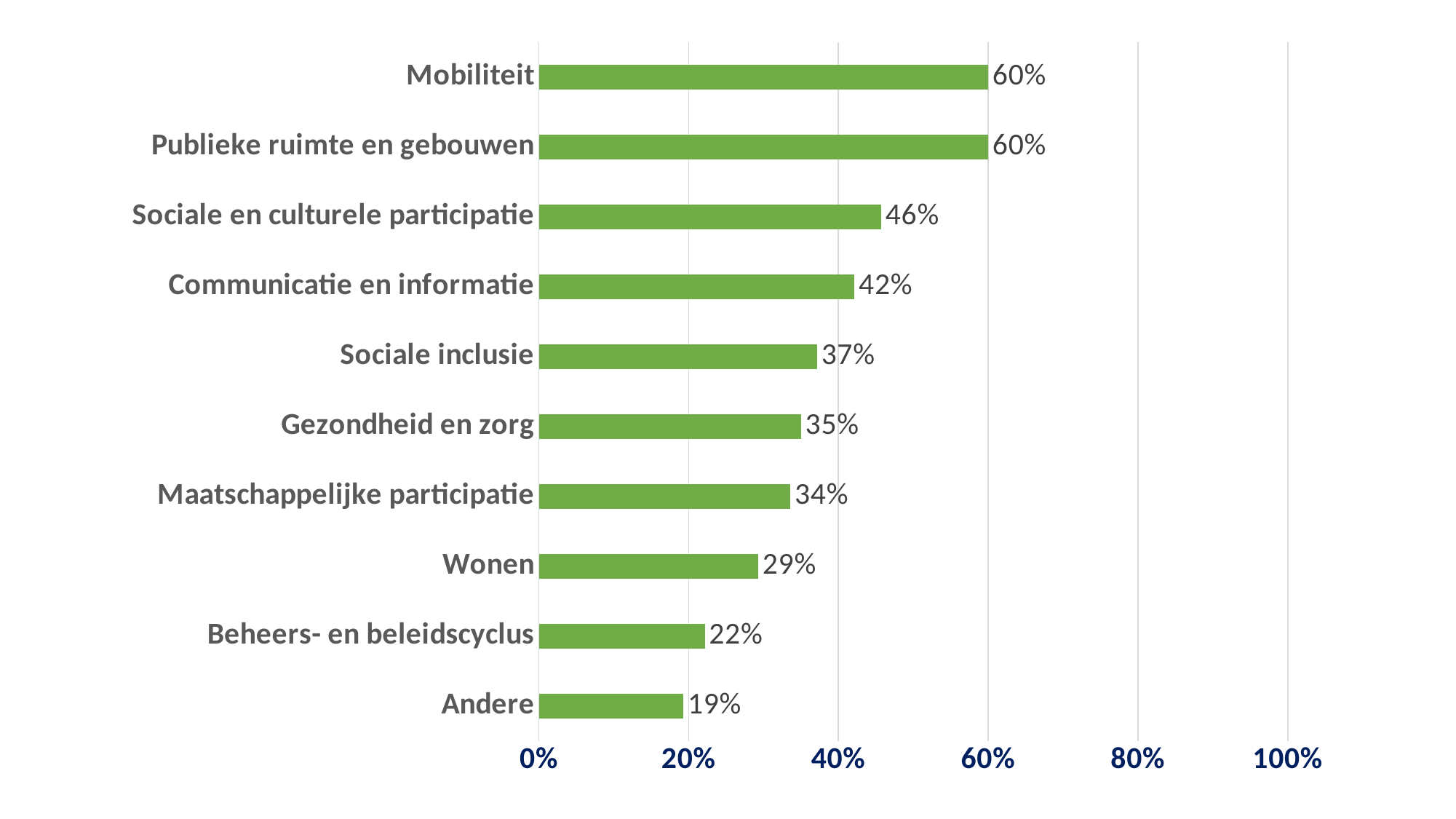
Is the value for Maatschappelijke participatie greater or less than 40%? less Which is larger, the value for Sociale inclusie or the value for Wonen? Sociale inclusie What is the value for Sociale en culturele participatie? 46% What is the difference between the values for Mobiliteit and Andere? 41% What is the difference between the values for Communicatie en informatie and Sociale inclusie? 5% What colour are the bars in the chart? green What is the value for Gezondheid en zorg? 35% What is the value for Wonen? 29% How many categories are shown in the chart? 10 What kind of chart is this? bar chart Which category has the lowest value? Andere What is the value for Beheers- en beleidscyclus? 22%